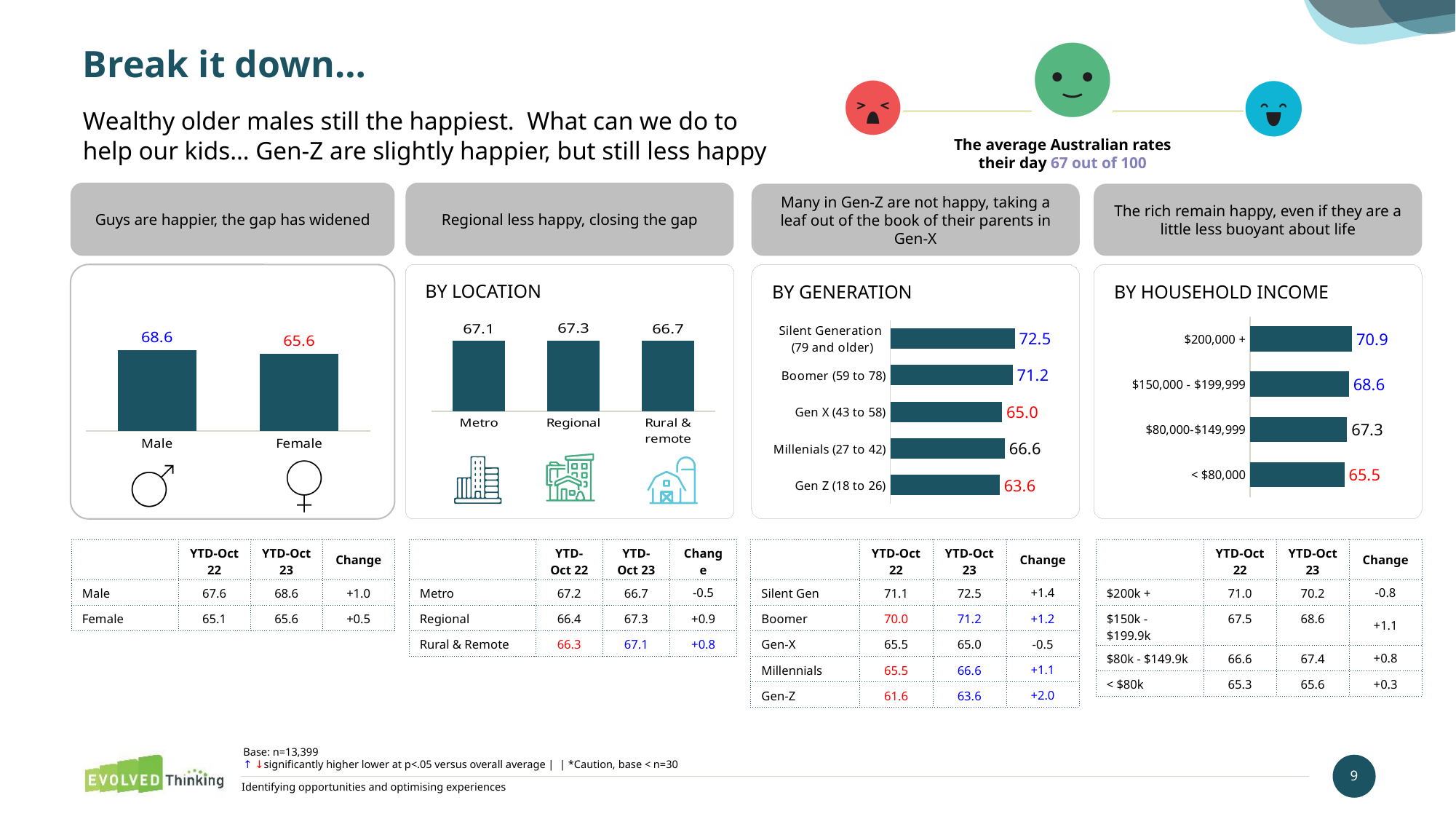
What type of chart is the BY HOUSEHOLD INCOME chart? Bar chart In the BY GENERATION chart, which is larger, the value for Boomer (59 to 78) or Millenials (27 to 42)? Boomer (59 to 78) In the leftmost chart (Male vs Female), what is the value for Male? 68.6 In the BY LOCATION chart, which location has the highest value? Regional In the BY LOCATION chart, how many locations are shown? 3 In the leftmost chart (Male vs Female), what is the difference between the Male and Female values? 3.0 In the BY HOUSEHOLD INCOME chart, what is the value for $150,000 - $199,999? 68.6 In the BY HOUSEHOLD INCOME chart, which income group has the lowest value? < $80,000 In the BY GENERATION chart, what is the difference between the Silent Generation and Gen Z values? 8.9 In the BY GENERATION chart, what is the value for Gen Z (18 to 26)? 63.6 In the BY GENERATION chart, which generation has the highest value? Silent Generation (79 and older) In the BY LOCATION chart, what is the value for Regional? 67.3